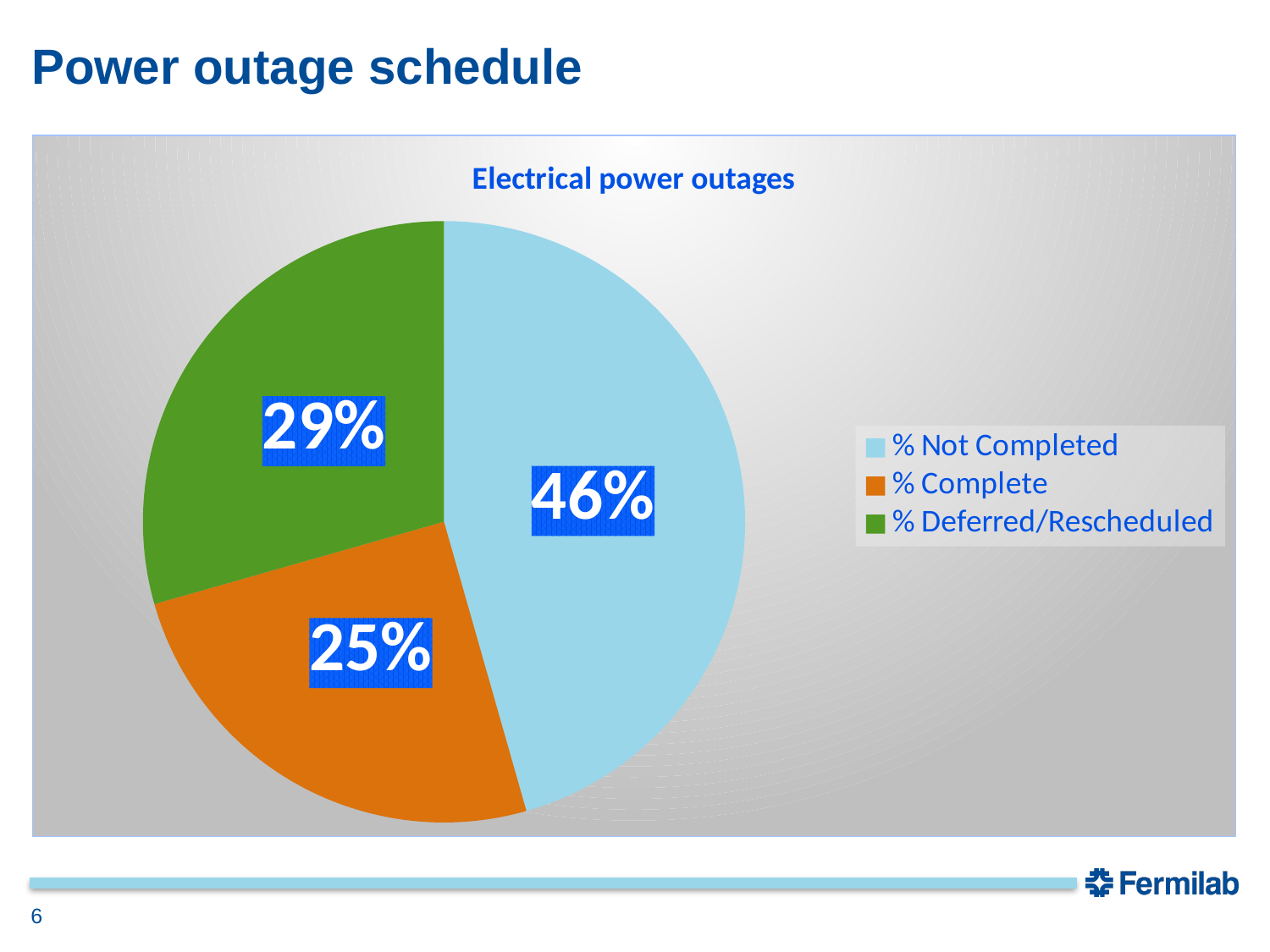
How many entries does the legend list? 3 Which category has the smallest slice of the pie? % Complete What colour is the % Deferred/Rescheduled slice? green What share of the pie is % Complete? 25% Which category has the largest slice of the pie? % Not Completed What is the title of the chart? Electrical power outages Which is larger, the % Deferred/Rescheduled share or the % Complete share? % Deferred/Rescheduled What is the difference between the % Not Completed share and the % Complete share? 21% What kind of chart is shown on the slide? pie chart What share of the pie is % Deferred/Rescheduled? 29% How many slices does the pie chart have? 3 What share of the pie is % Not Completed? 46%